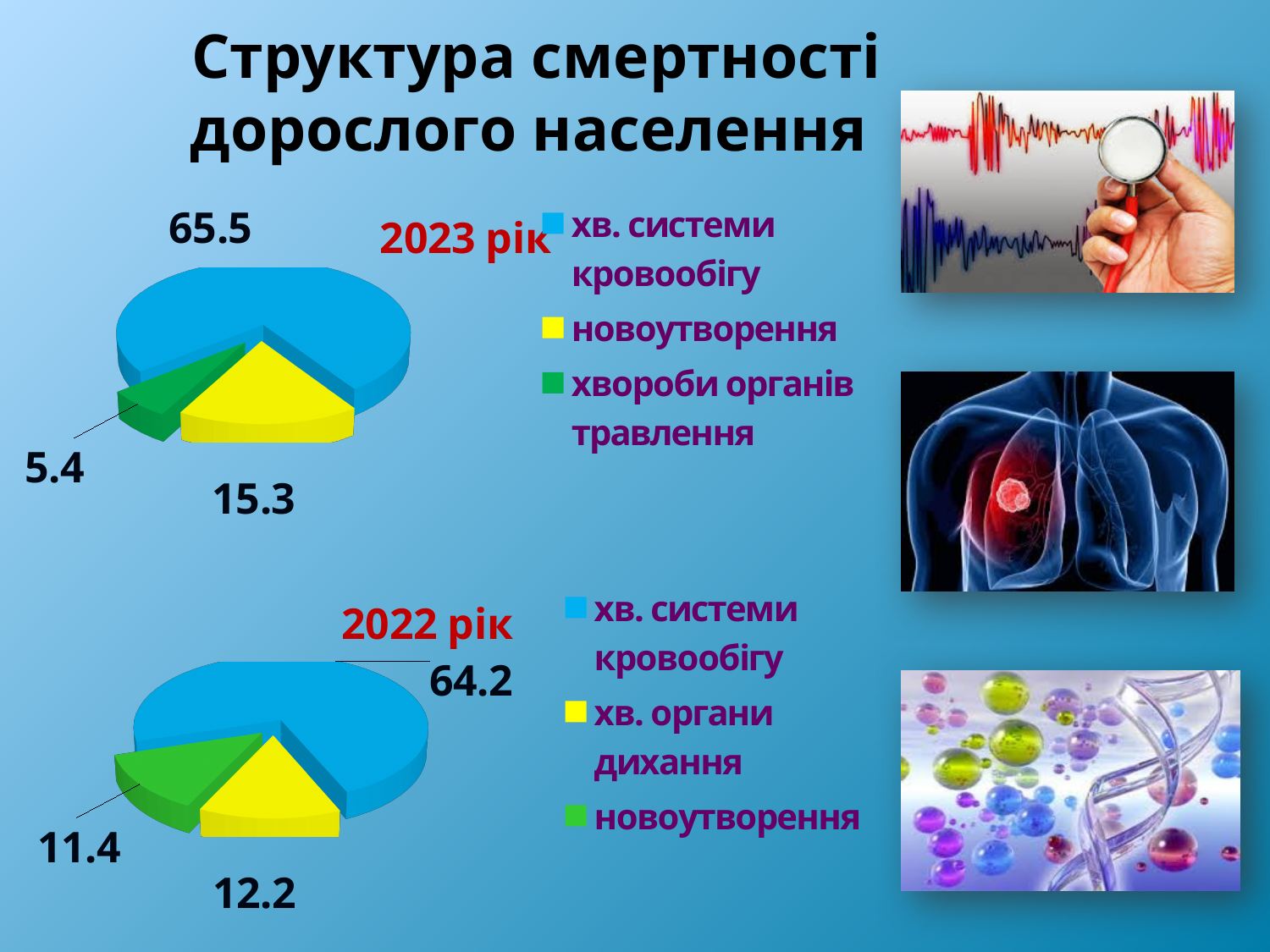
In the 2022 рік chart, what is the value for новоутворення? 11.4 In the 2022 рік chart, what is the difference between the values for хв. органи дихання and новоутворення? 0.8 In the 2023 рік chart, what is the value for хвороби органів травлення? 5.4 What type of chart is the 2023 рік chart? pie chart How many slices does the 2022 рік chart have? 3 In the 2022 рік chart, which category has the largest slice? хв. системи кровообігу In the 2023 рік chart, which category has the smallest slice? хвороби органів травлення In the 2022 рік chart, what is the value for хв. органи дихання? 12.2 Which is larger: the value for хв. системи кровообігу in the 2023 рік chart or in the 2022 рік chart? 2023 рік In the 2023 рік chart, what is the difference between the values for новоутворення and хвороби органів травлення? 9.9 In the 2023 рік chart, what is the value for новоутворення? 15.3 In the 2023 рік chart, what is the value for хв. системи кровообігу? 65.5